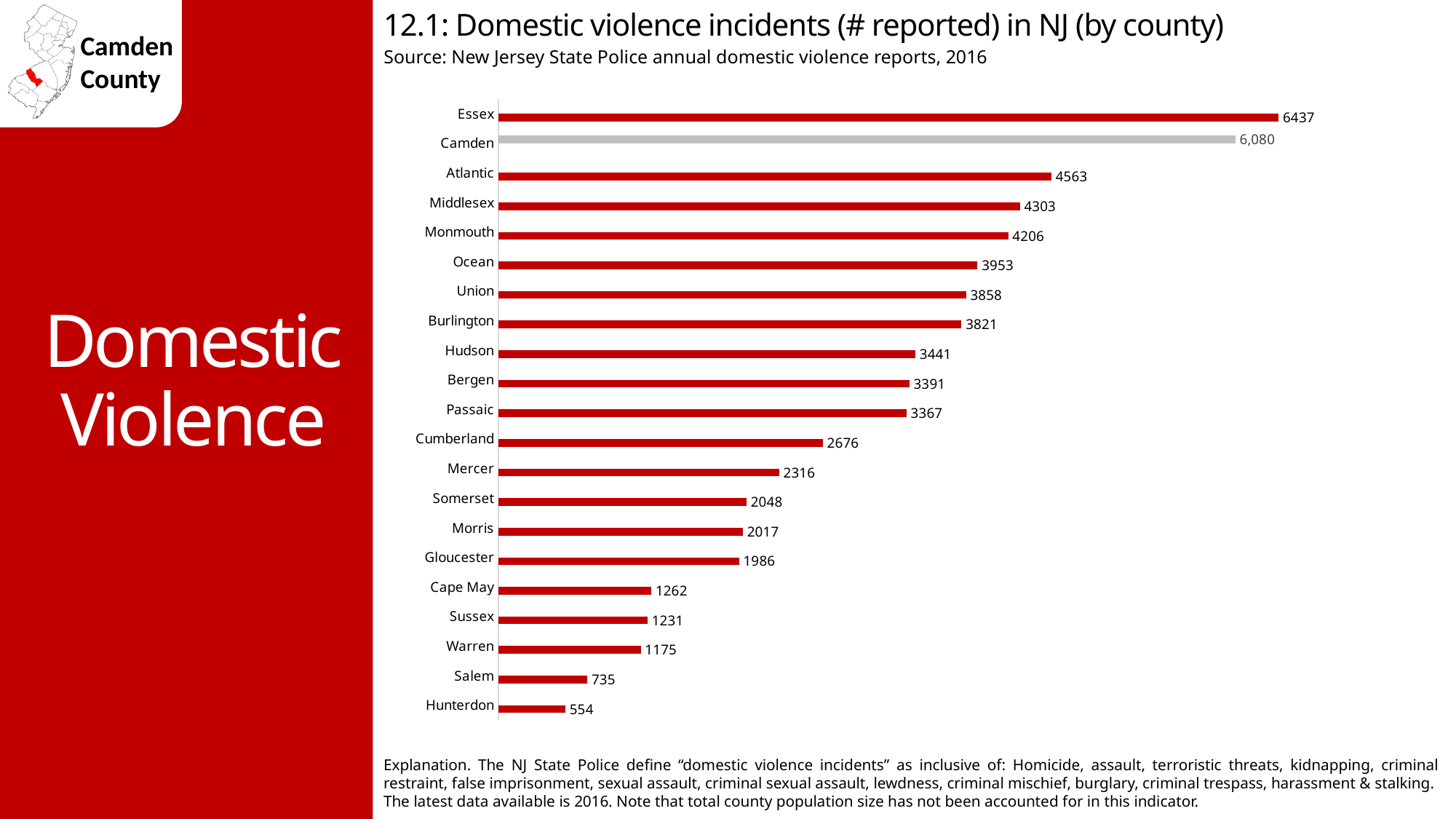
How many domestic violence incidents were reported in Camden County? 6,080 Which county has the lowest number of reported domestic violence incidents? Hunterdon What type of chart is shown on the slide? bar chart How many counties are shown in the chart? 21 How many domestic violence incidents were reported in Atlantic County? 4563 What is the value for Salem County? 735 Which county has a higher value, Mercer or Cumberland? Cumberland What is the difference between the values for Essex and Camden? 357 What is the difference between the values for Salem and Hunterdon? 181 Which bar is shown in a different colour (grey) from the others? Camden What is the value for Gloucester County? 1986 Which county has the highest number of reported domestic violence incidents? Essex